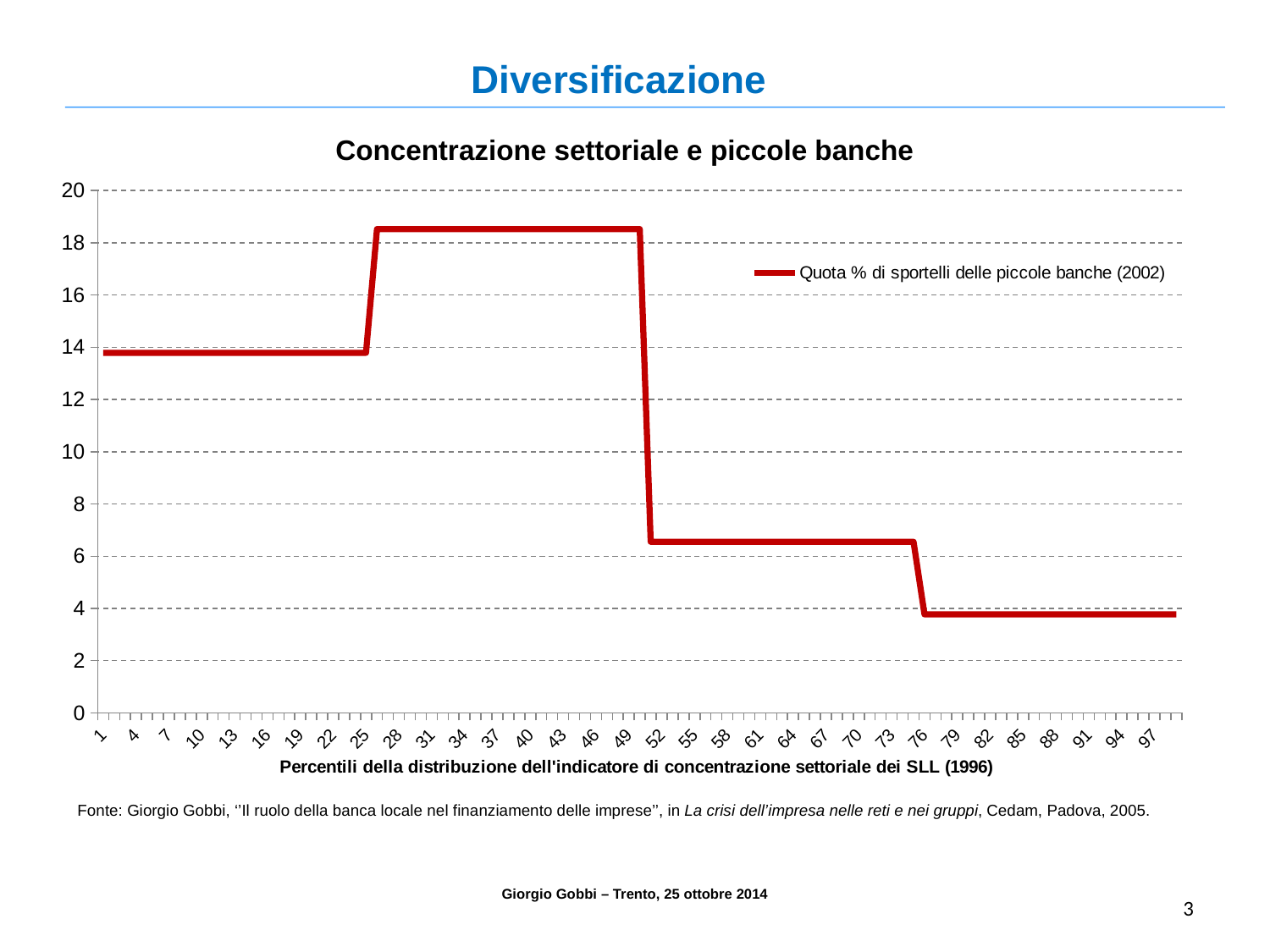
Is the value at percentile 40 greater or less than 18? greater Is the value at percentile 97 higher or lower than the value at percentile 1? lower How many series does the legend list? 1 What is the legend entry for the plotted series? Quota % di sportelli delle piccole banche (2002) Is the value at percentile 90 greater or less than 6? less Is the value at percentile 10 greater or less than 12? greater What kind of chart is shown on the slide? line chart Which is larger, the value at percentile 10 or the value at percentile 90? percentile 10 Do the values rise or fall between percentile 50 and percentile 97? fall Which is larger, the value at percentile 40 or the value at percentile 60? percentile 40 What is the title of the chart? Concentrazione settoriale e piccole banche